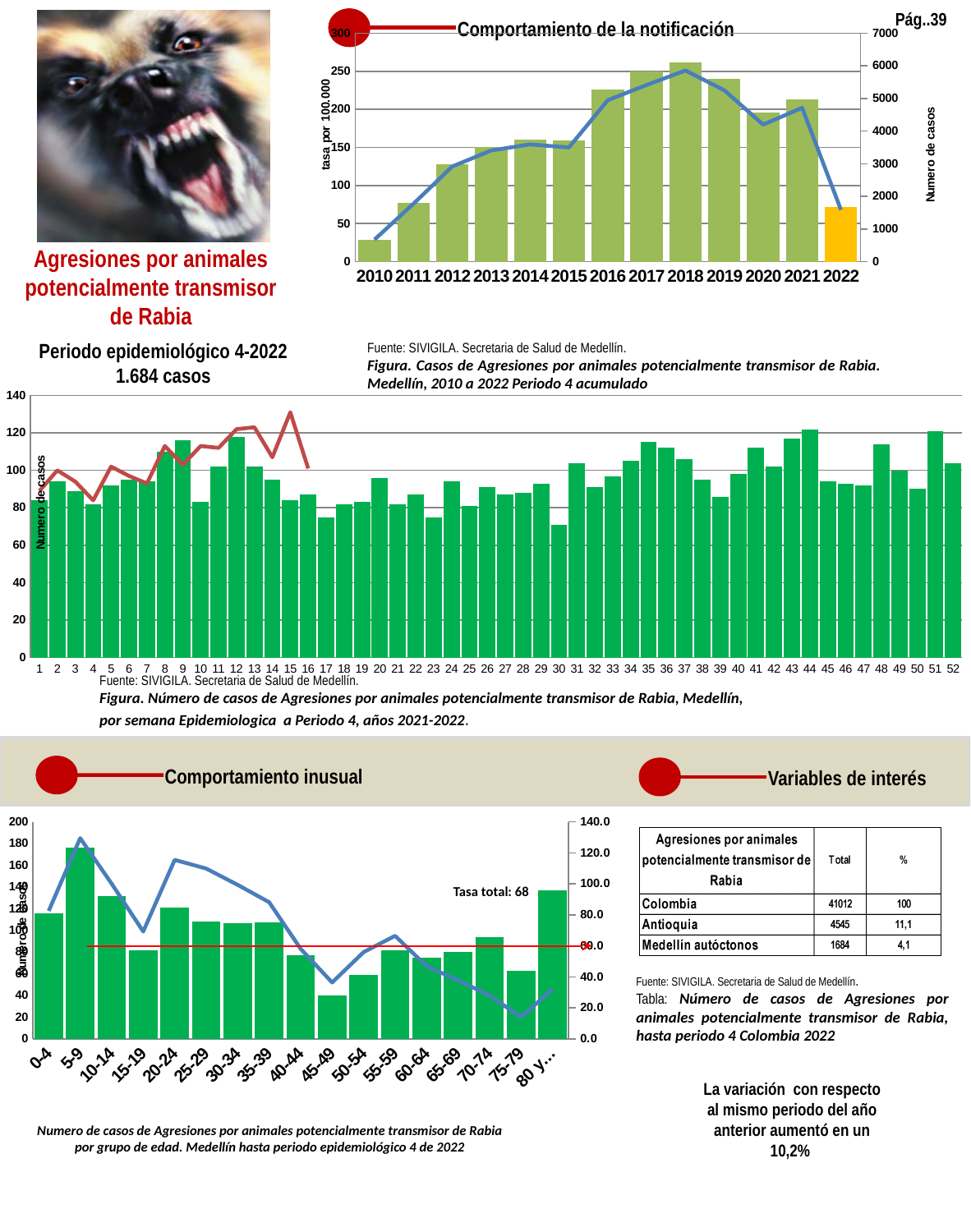
In the 'Comportamiento de la notificación' chart, how many years are shown on the x axis? 13 In the weekly chart, is the bar for week 12 greater or less than 100 cases? greater In the 'Comportamiento de la notificación' chart, which year has the shortest bar? 2010 In the 'Comportamiento de la notificación' chart, which year has the tallest bar? 2018 In the age-group chart at the bottom left, what is the 'Tasa total' value printed on the chart? 68 In the age-group chart at the bottom left, which age group has the tallest bar? 5-9 In the weekly chart (Número de casos por semana epidemiológica), how many weeks are shown on the x axis? 52 In the age-group chart at the bottom left, which age group has the shortest bar? 75-79 In the weekly chart, is the bar for week 30 greater or less than 80 cases? less In the 'Comportamiento de la notificación' chart, which bar is coloured differently (orange) from the others? 2022 In the 'Comportamiento de la notificación' chart, is the bar for 2018 greater or less than 5000 cases? greater